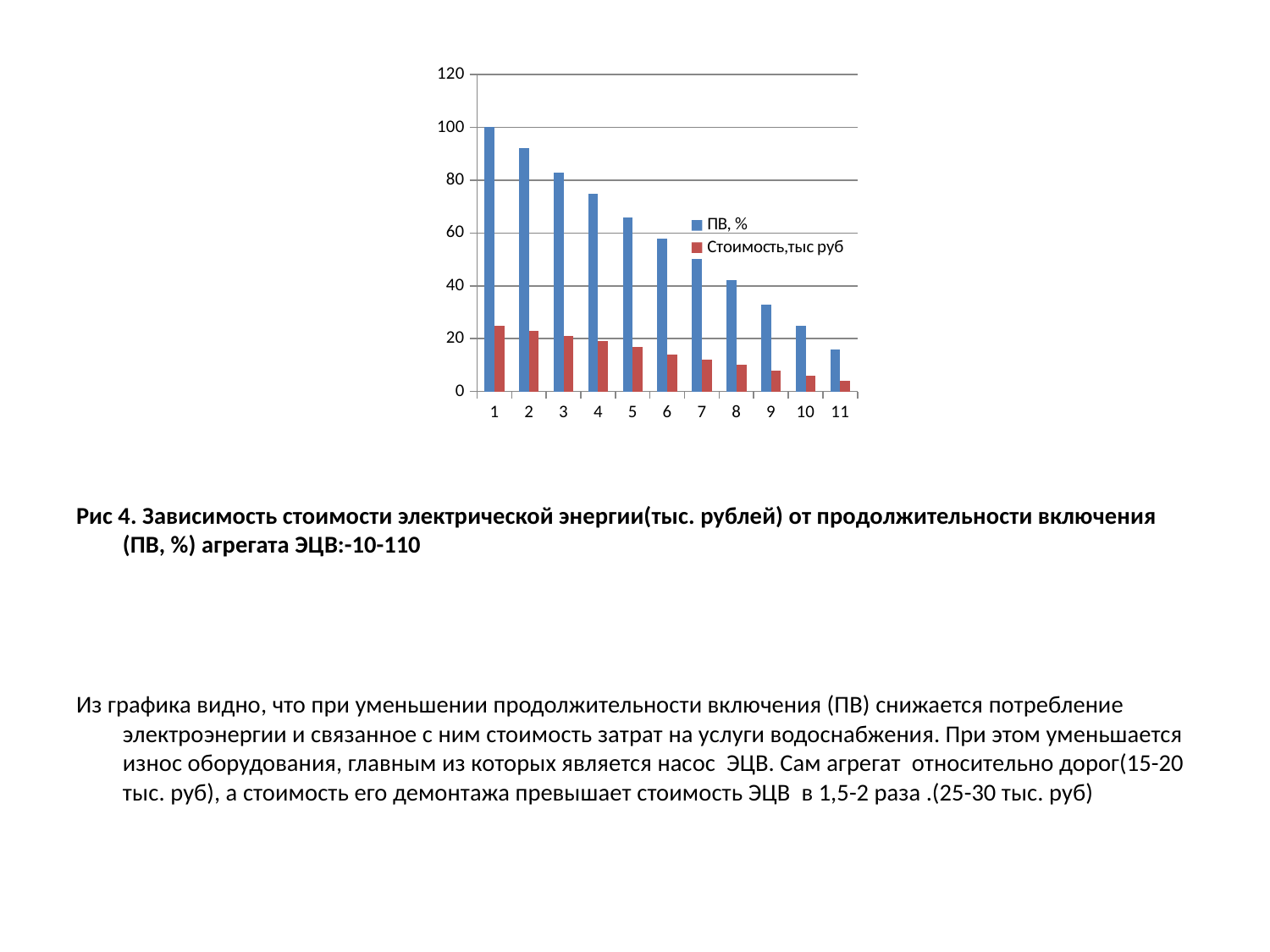
For category 5, which series has the larger value, ПВ, % or Стоимость,тыс руб? ПВ, % What kind of chart is shown on the slide? bar chart How many series does the legend list? 2 Do the values of the ПВ, % series rise or fall from category 1 to category 11? fall Is the value of Стоимость,тыс руб for category 1 greater or less than 20? greater Which category has the lowest value for Стоимость,тыс руб? 11 What colour are the bars for the ПВ, % series? blue How many categories are shown along the x axis? 11 Which category has the highest value for ПВ, %? 1 What is the value of ПВ, % for category 1? 100 Is the value of ПВ, % for category 9 greater or less than 40? less Is the value of ПВ, % for category 2 greater or less than 80? greater